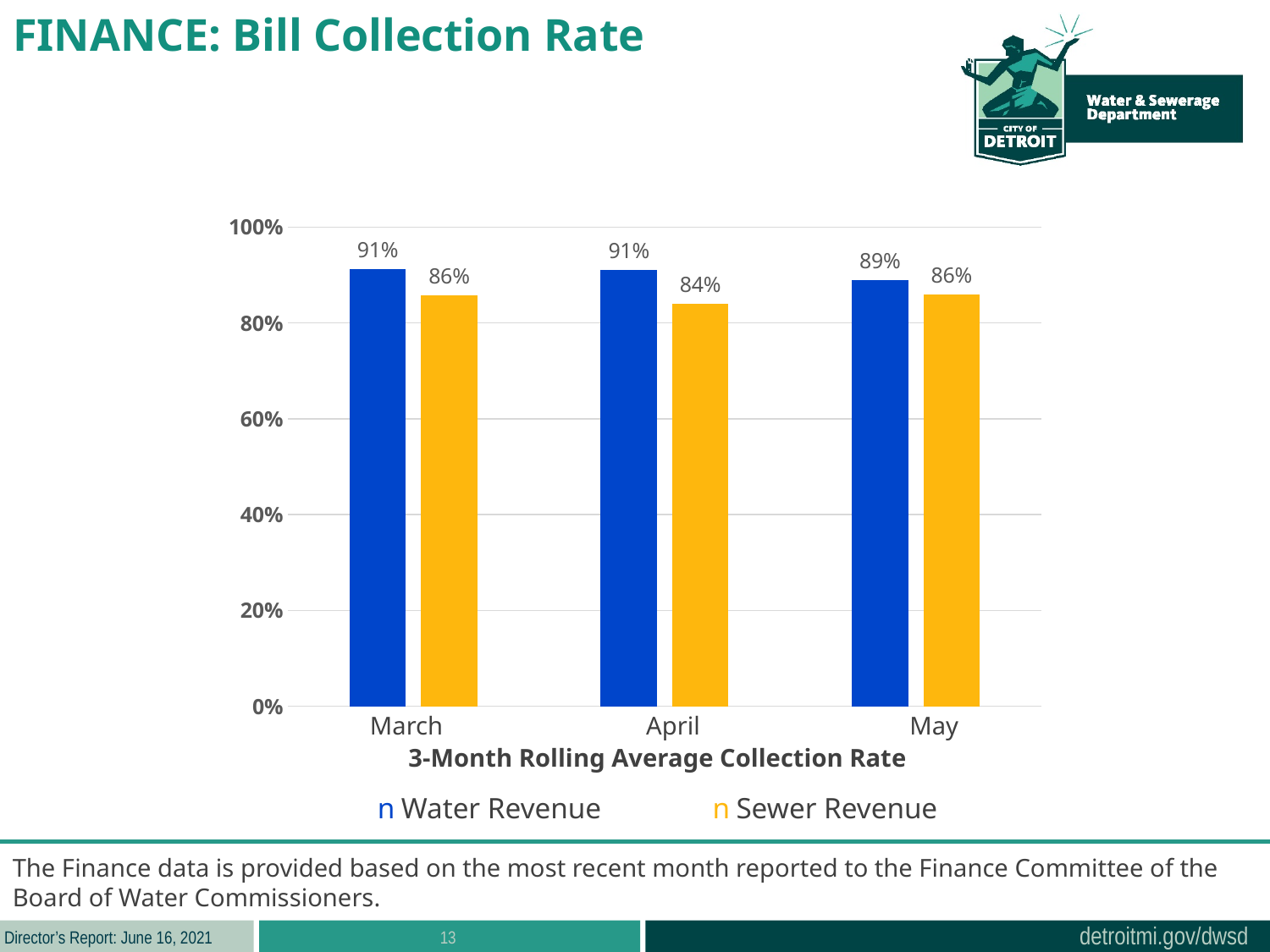
Which is larger in March, the Water Revenue or the Sewer Revenue collection rate? Water Revenue Which month has the lowest Water Revenue collection rate? May What is the Water Revenue collection rate for March? 91% How many series does the legend list? 2 What is the difference between the Water Revenue collection rate in March and in May? 2% What is the Sewer Revenue collection rate for April? 84% What kind of chart is shown on the slide? Bar chart How many months are shown on the x axis? 3 What is the Sewer Revenue collection rate for May? 86% What is the Water Revenue collection rate for May? 89% What is the difference between the Water Revenue and Sewer Revenue collection rates in April? 7% Which month has the lowest Sewer Revenue collection rate? April